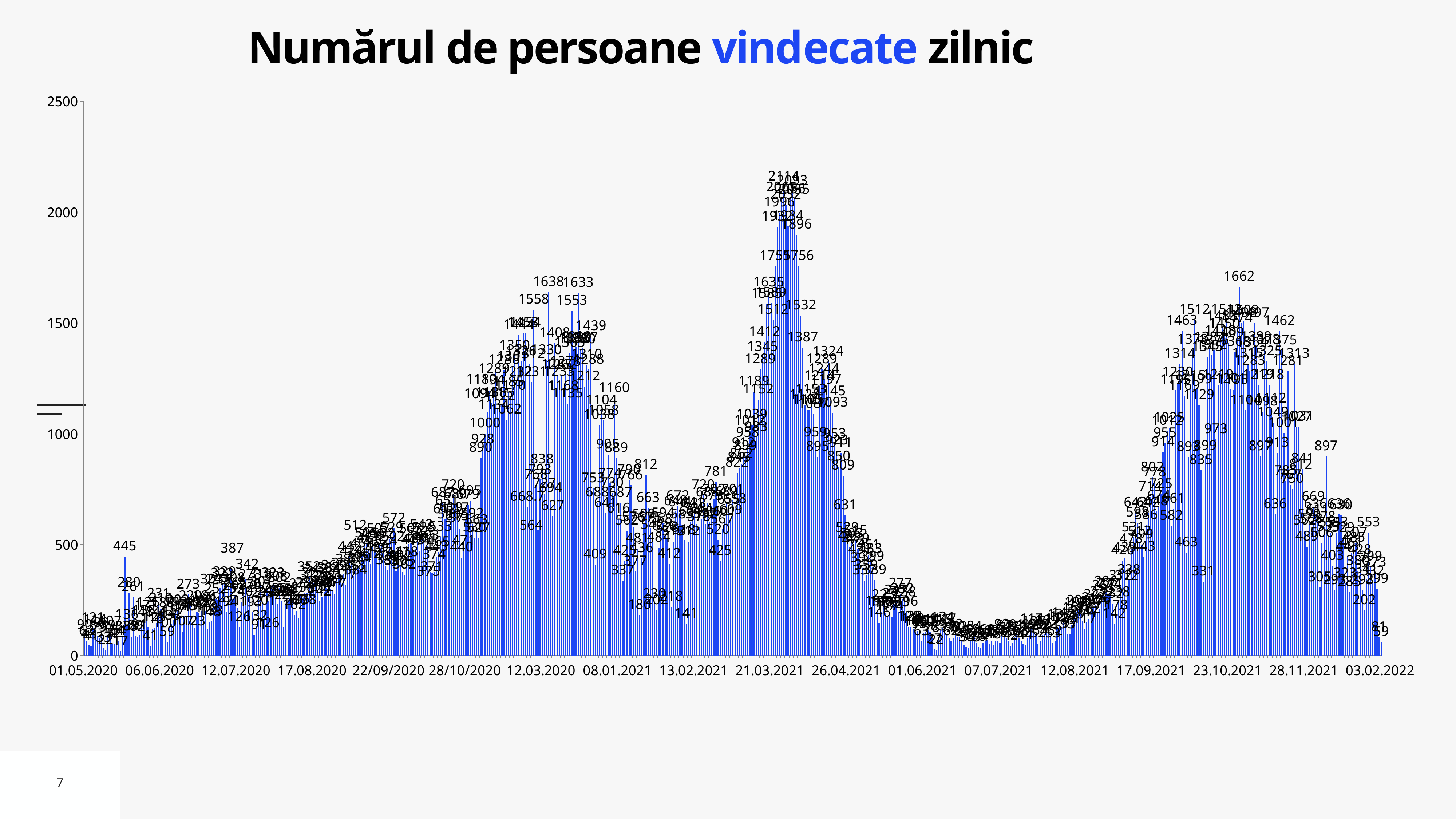
What is the highest data label in the wave around 23.10.2021? 1662 What is the highest data label shown on the chart? 2114 Is the highest value on the chart greater or less than 2000? greater Are the values around 07.07.2021 greater or less than 500? less Which is larger: the peak around 21.03.2021 or the peak around 23.10.2021? the peak around 21.03.2021 What kind of chart is shown on the slide? bar chart Is the value at the first date, 01.05.2020, greater or less than 500? less What is the last date shown on the horizontal axis? 03.02.2022 What is the highest data label shown before 06.06.2020? 445 What is the title of the chart? Numărul de persoane vindecate zilnic What is the maximum value shown on the vertical axis? 2500 What is the difference between the overall peak value of 2114 and the autumn 2021 peak of 1662? 452